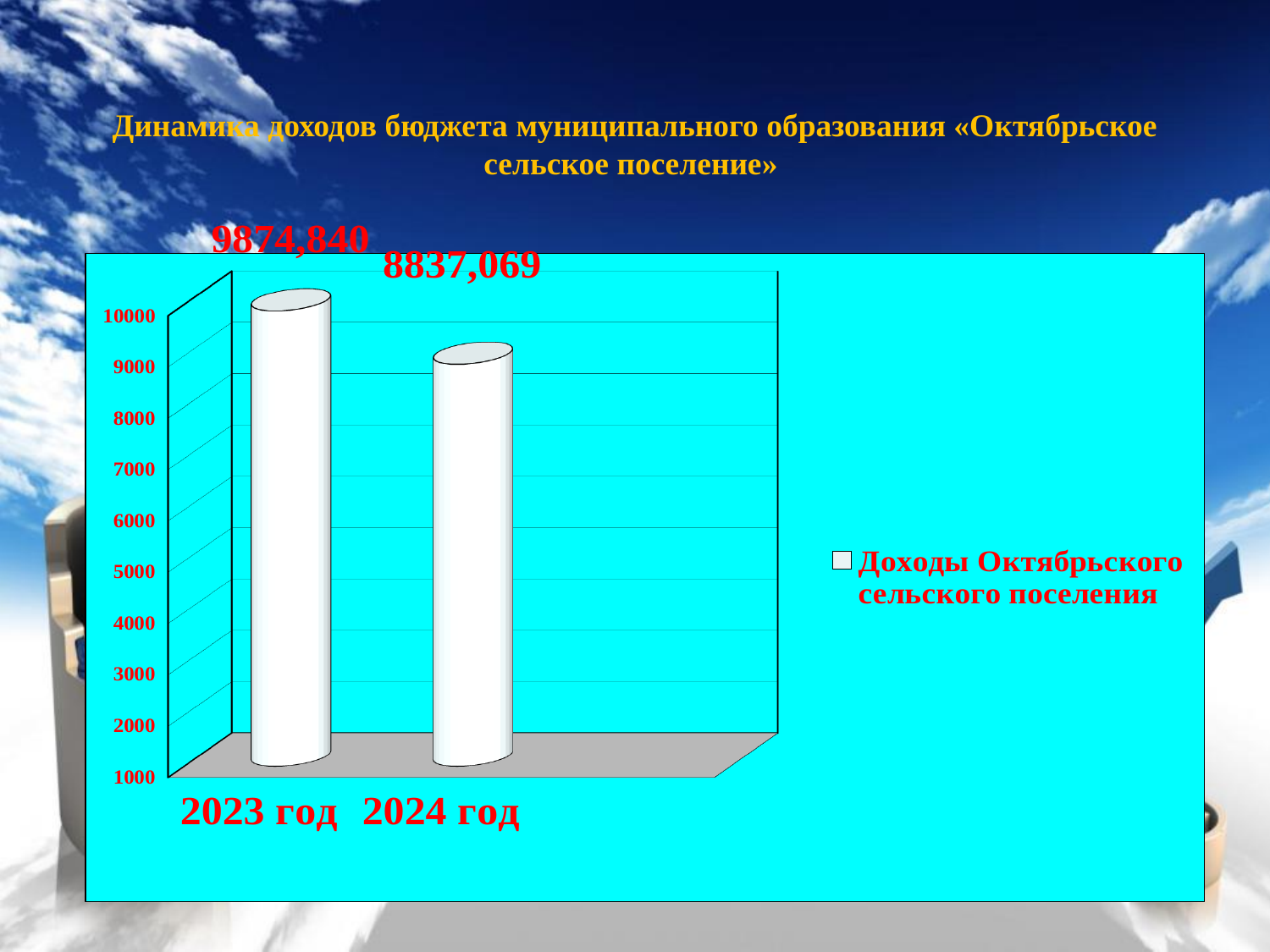
How many series does the legend list? 1 What is the difference between the values for 2023 год and 2024 год? 1037,771 What is the value for 2024 год? 8837,069 How many categories are shown on the x axis? 2 Is the value for 2024 год greater or less than 8000? greater Which is larger, the value for 2023 год or the value for 2024 год? 2023 год Is the value for 2023 год greater or less than 9000? greater What kind of chart is shown on the slide? bar chart Which year has the highest value? 2023 год What is the value for 2023 год? 9874,840 Do the values rise or fall from 2023 год to 2024 год? fall Which year has the lowest value? 2024 год